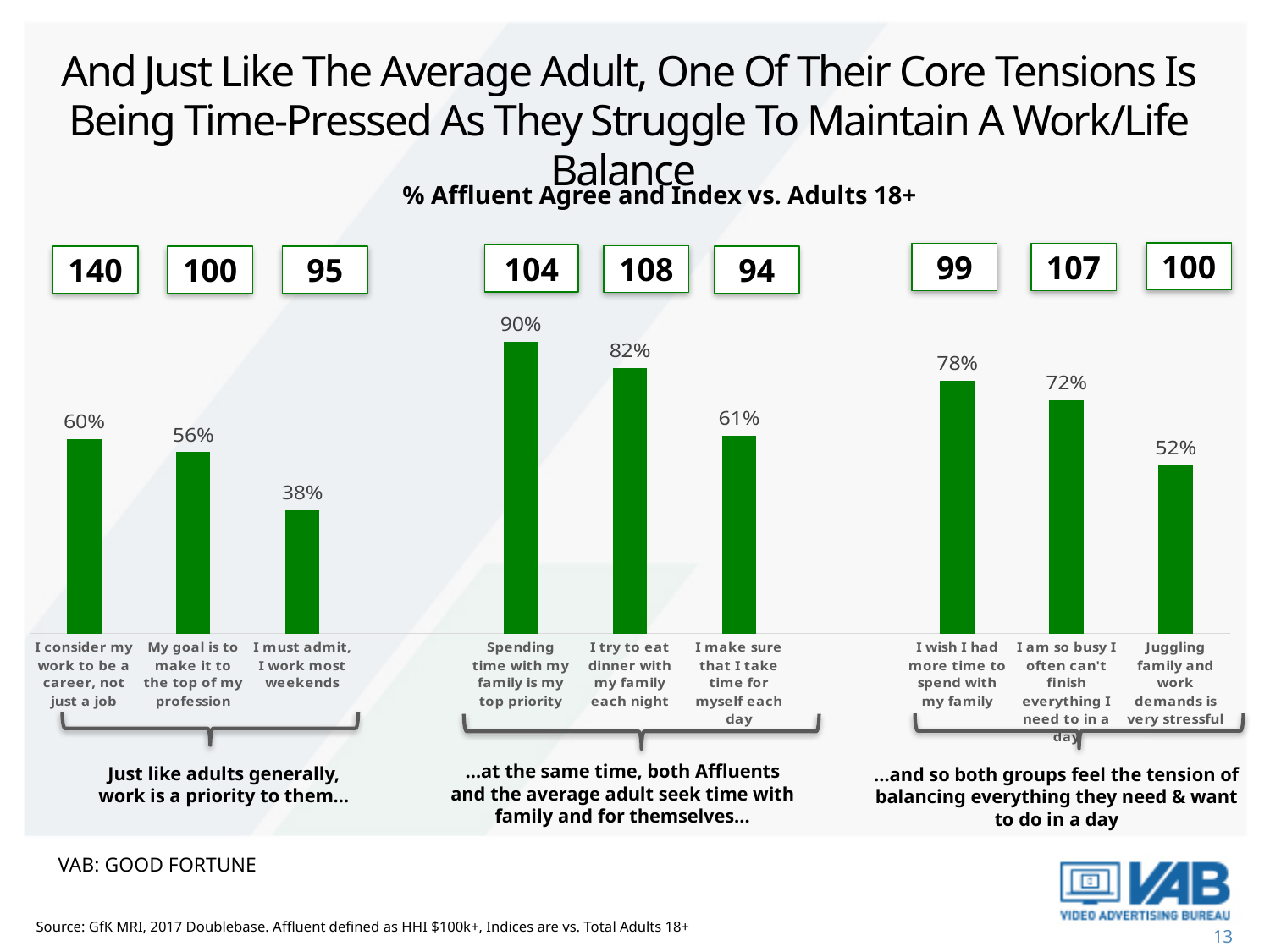
In the left chart, what percentage of Affluents agree with "I consider my work to be a career, not just a job"? 60% In the left chart, which statement has the lowest percentage agreeing? I must admit, I work most weekends What type of chart is used in the middle chart? Bar chart In the right chart, what is the difference in percentage points between "I wish I had more time to spend with my family" and "Juggling family and work demands is very stressful"? 26 In the left chart, do the percentages rise or fall from left to right? Fall How many bars are in the left chart? 3 In the middle chart, what percentage agree that "Spending time with my family is my top priority"? 90% In the middle chart, which statement has the highest percentage agreeing? Spending time with my family is my top priority In the right chart, what percentage agree with "Juggling family and work demands is very stressful"? 52% What is the subtitle shown above the three charts? % Affluent Agree and Index vs. Adults 18+ In the left chart, what is the index vs. Adults 18+ shown above "I consider my work to be a career, not just a job"? 140 In the middle chart, which is larger: the percentage for "I try to eat dinner with my family each night" or for "I make sure that I take time for myself each day"? I try to eat dinner with my family each night